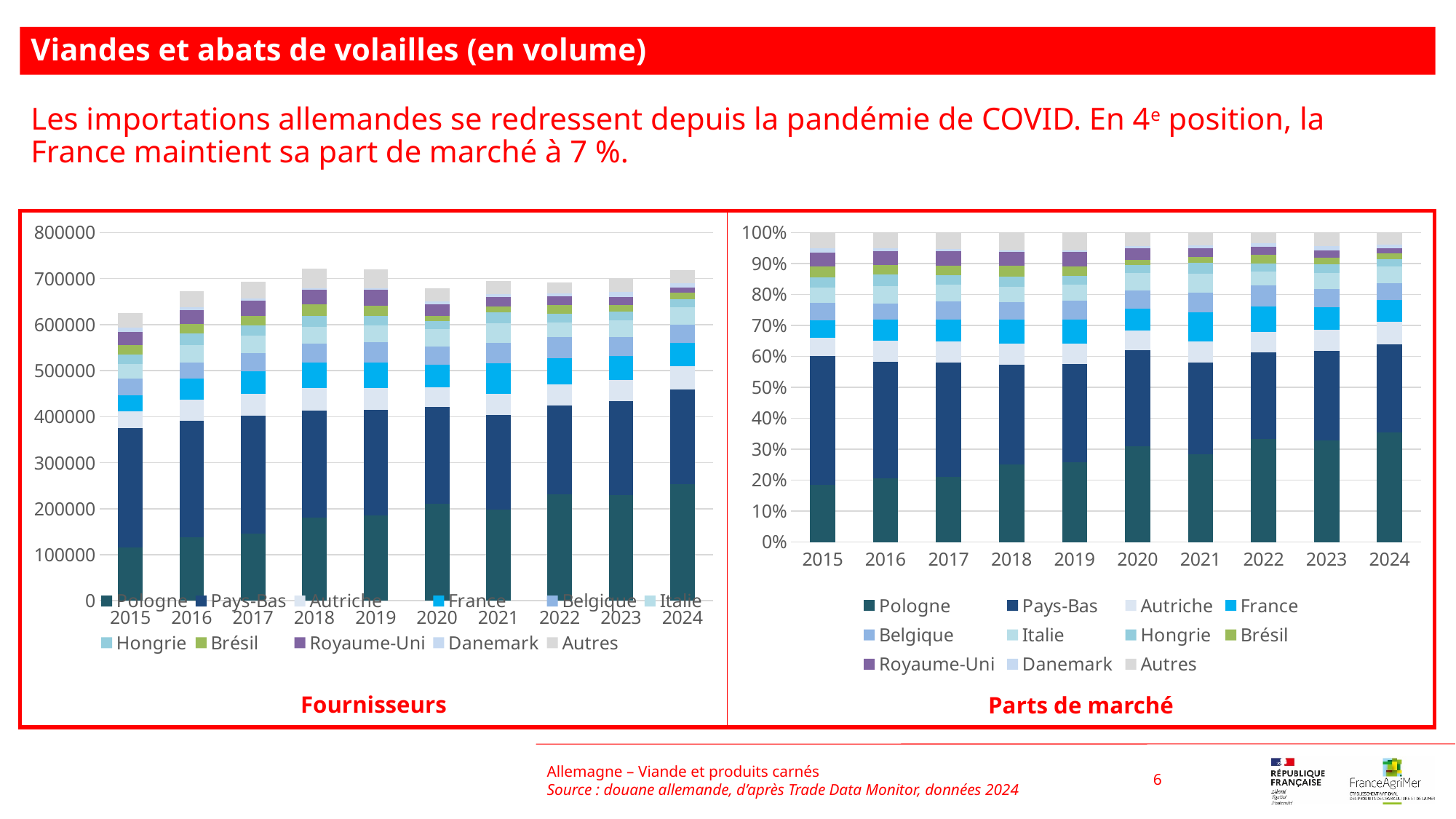
In the 'Fournisseurs' chart, which year has the lowest total bar? 2015 How many years are shown on the x axis of the 'Parts de marché' chart? 10 In the 'Fournisseurs' chart, which total bar is larger, 2015 or 2024? 2024 What kind of chart is the 'Fournisseurs' chart on the left? stacked bar chart In the 'Parts de marché' chart, does the Pologne share rise or fall from 2015 to 2024? rise In the 'Parts de marché' chart, is the Pologne share for 2015 greater or less than 20%? less In the 'Fournisseurs' chart, is the Pologne value for 2024 greater or less than 200000? greater Which series is listed first in the legend of the 'Fournisseurs' chart? Pologne In the 'Parts de marché' chart, is the Pologne share for 2024 greater or less than 30%? greater How many series does the legend of the 'Parts de marché' chart list? 11